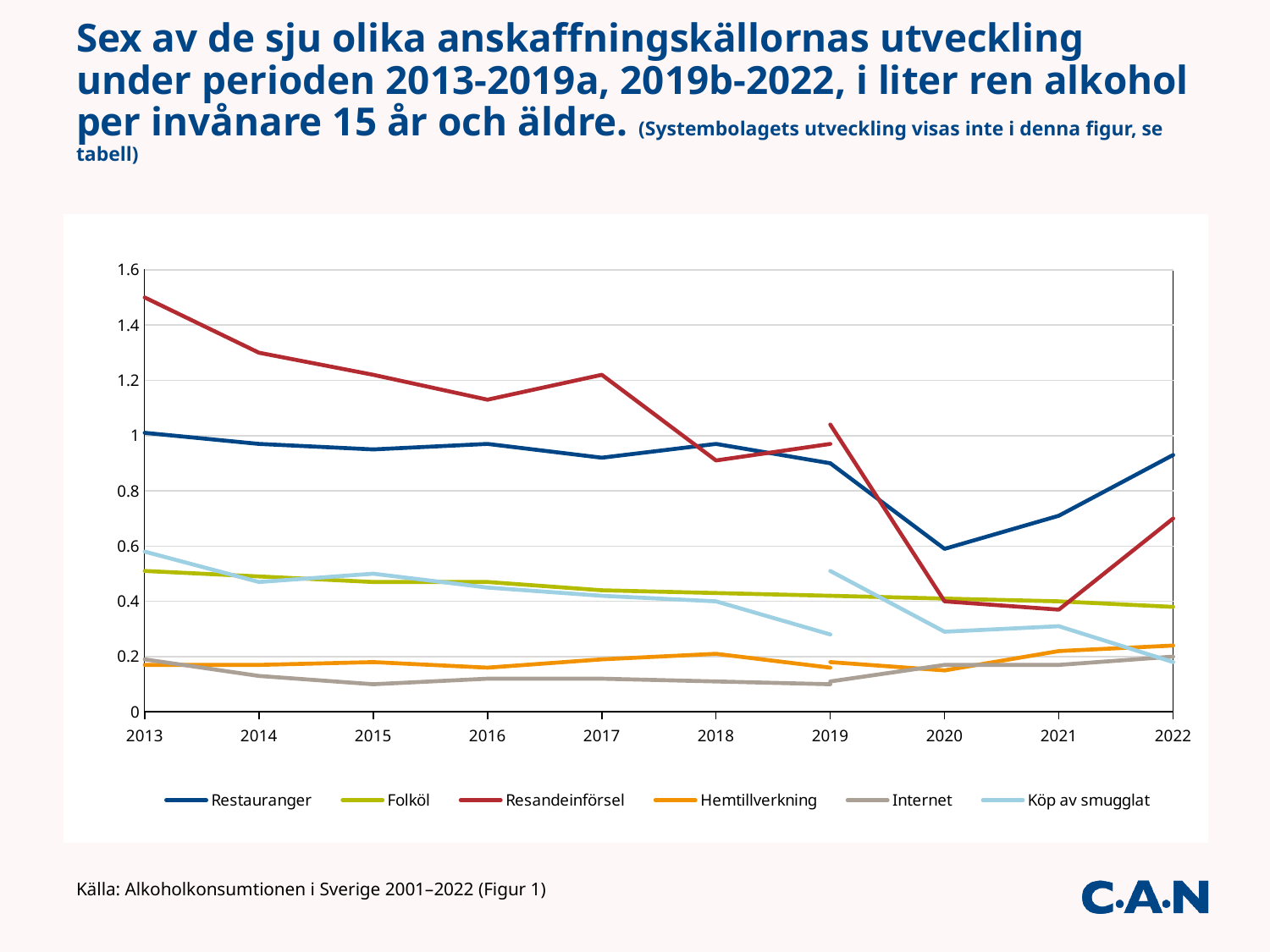
Which series has the lowest value in 2015? Internet Which series has the highest value in 2022? Restauranger Is the value for Restauranger in 2022 greater or less than 0.8? greater Which series has the highest value in 2013? Resandeinförsel Is the value for Internet in 2015 greater or less than 0.2? less How many years are labelled on the x axis? 10 What kind of chart is shown on the slide? Line chart Which series is drawn in red? Resandeinförsel Does the Folköl series rise or fall from 2013 to 2022? Fall Is the value for Resandeinförsel in 2013 greater or less than 1.4? greater How many series does the legend list? 6